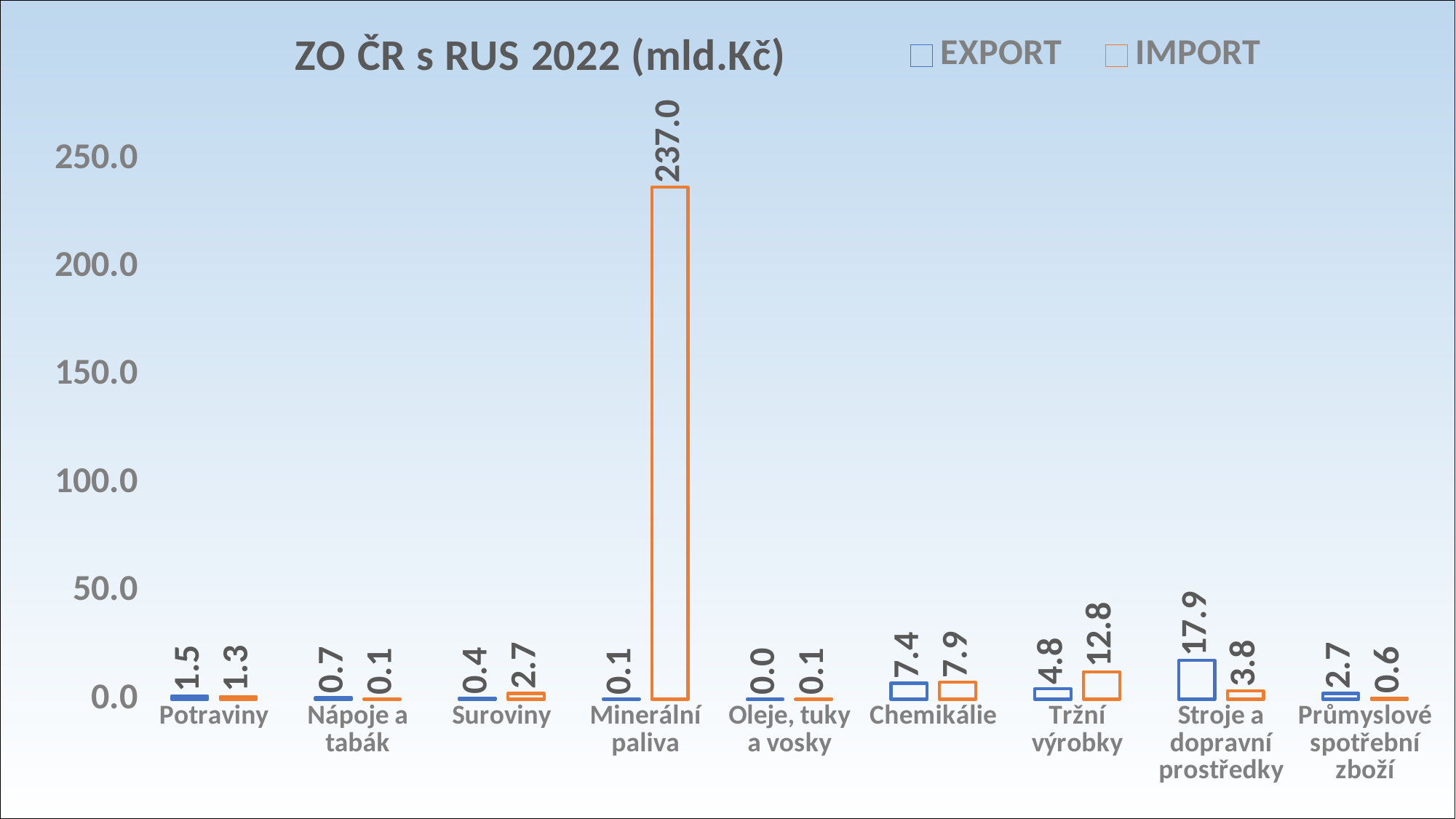
Which category has the highest EXPORT value? Stroje a dopravní prostředky What is the IMPORT value for Minerální paliva? 237.0 What is the IMPORT value for Tržní výrobky? 12.8 What kind of chart is shown on the slide? Bar chart Which is larger for Suroviny, EXPORT or IMPORT? IMPORT What is the EXPORT value for Chemikálie? 7.4 What is the difference between the IMPORT and EXPORT values for Tržní výrobky? 8.0 What is the EXPORT value for Stroje a dopravní prostředky? 17.9 How many categories are shown on the x axis? 9 Which category has the highest IMPORT value? Minerální paliva How many series does the legend list? 2 Which category has the lowest EXPORT value? Oleje, tuky a vosky